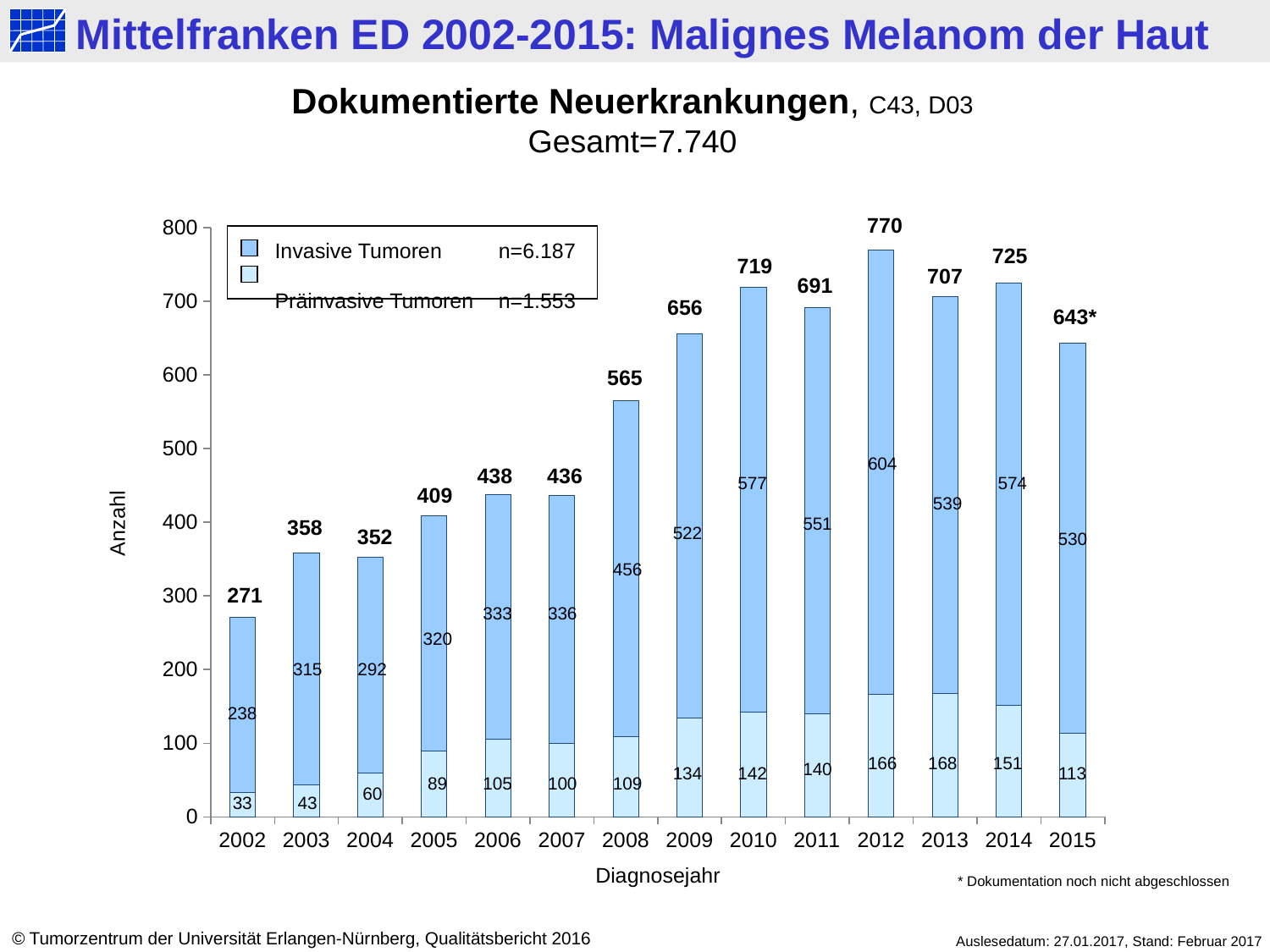
How many invasive tumours (Invasive Tumoren) were documented in 2010? 577 What is the value for Präinvasive Tumoren in 2013? 168 How many diagnosis years are shown on the x axis? 14 According to the legend, what is the n for Invasive Tumoren? n=6.187 How many series does the legend list? 2 Which diagnosis year has the lowest total number of new cases? 2002 What kind of chart is shown on the slide? stacked bar chart Which diagnosis year has the highest total number of new cases? 2012 Is the total value for 2008 greater or less than 500? greater What is the difference between the total for 2012 and the total for 2002? 499 What is the total number of new cases for 2009? 656 Which year has more invasive tumours, 2011 or 2014? 2014